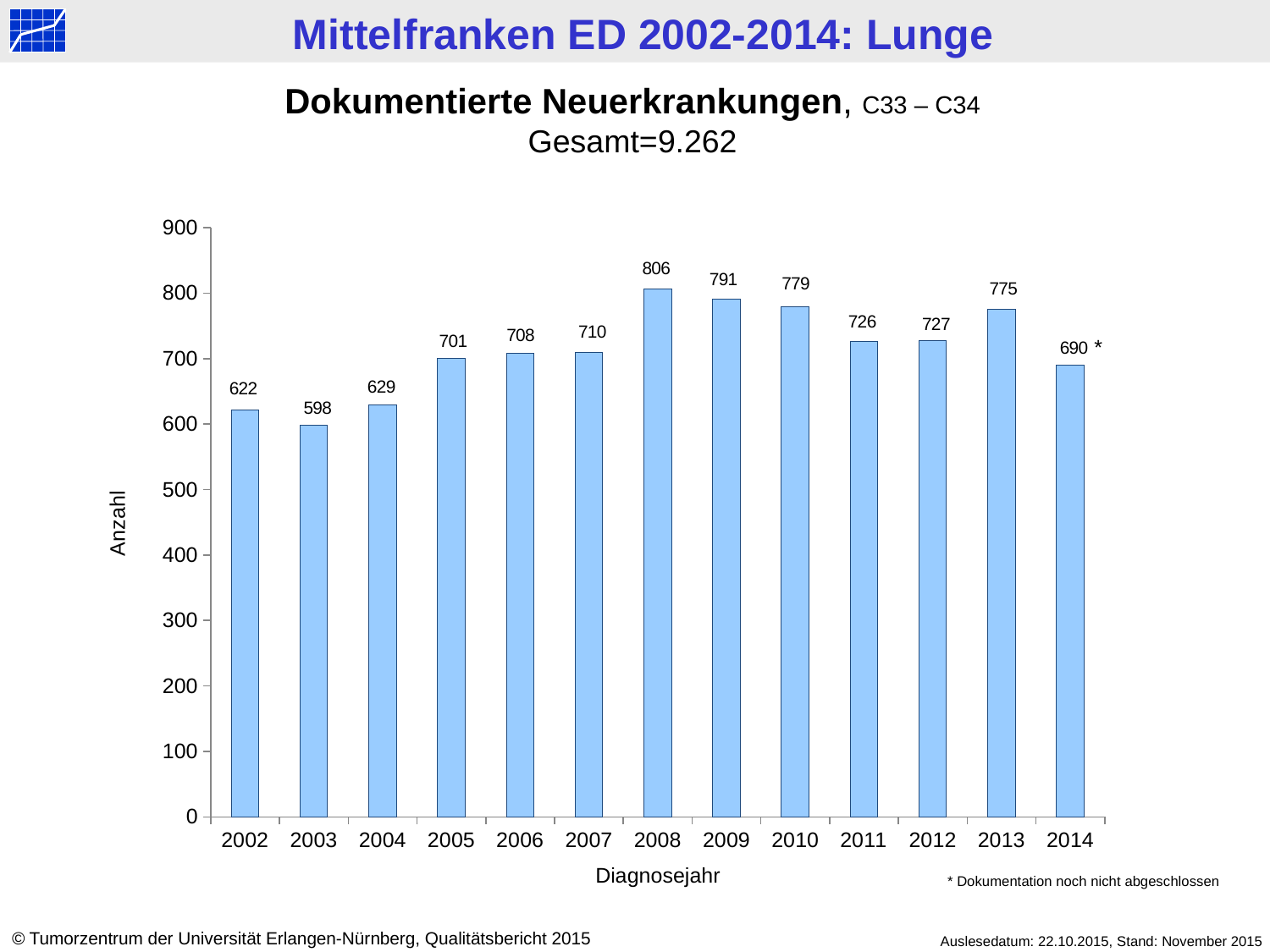
How many years are shown on the x axis? 13 What is the value for 2003? 598 Which year has the lowest value? 2003 Which year has the highest value? 2008 What is the label of the y axis? Anzahl Which is larger, the value for 2009 or the value for 2010? 2009 What is the difference between the values for 2013 and 2014? 85 What is the difference between the values for 2008 and 2003? 208 What is the value for 2014? 690 Is the value for 2005 greater or less than 600? greater What kind of chart is shown? bar chart What is the value for 2008? 806